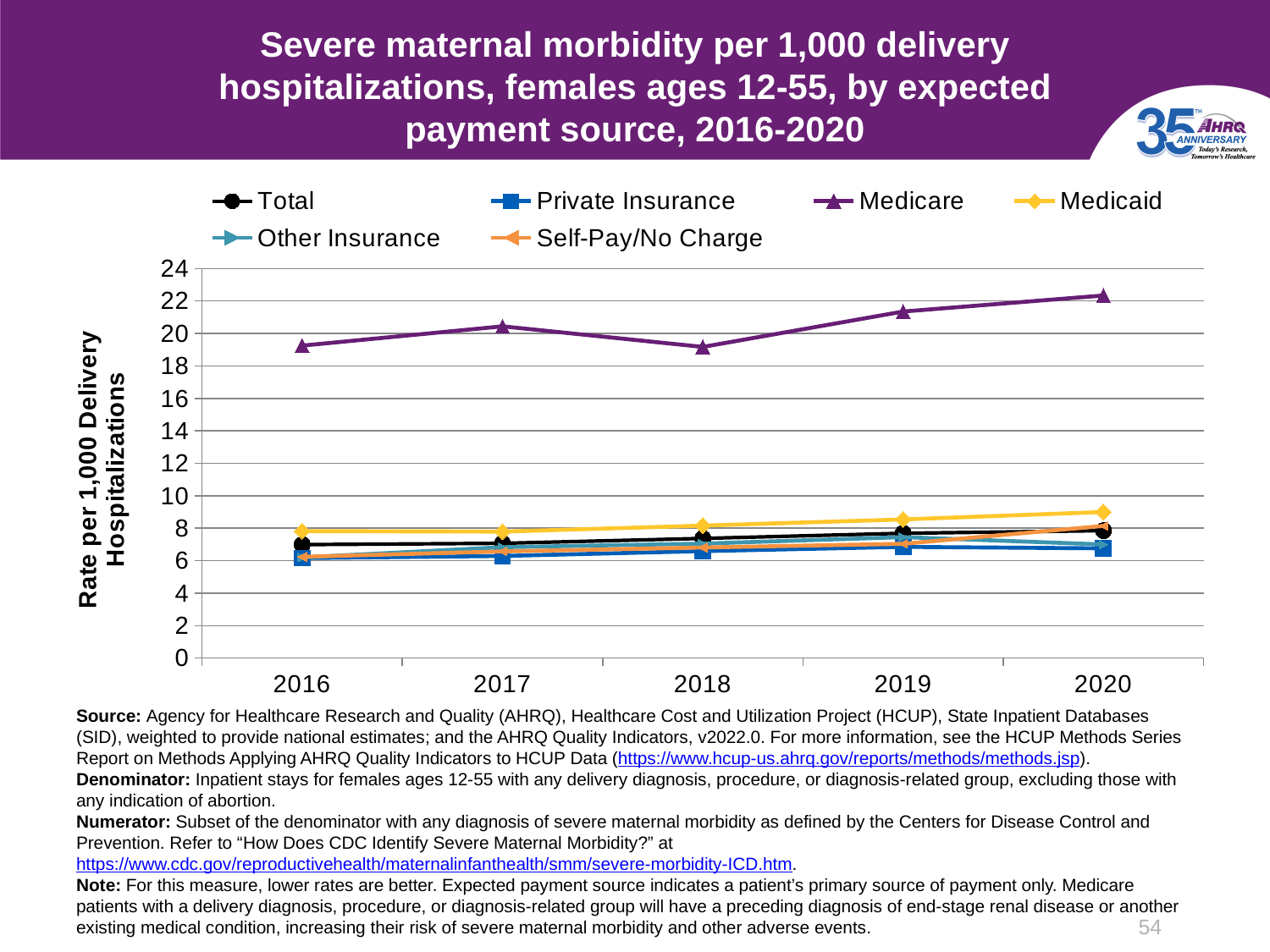
Does the Medicaid rate rise or fall from 2016 to 2020? rise Which payment source has the highest severe maternal morbidity rate in every year shown? Medicare What kind of chart is shown on the slide? line chart Is the value for Private Insurance in 2017 greater or less than 8? less Is the value for Medicare in 2019 greater or less than 20? greater Is the value for Total in 2016 greater or less than 8? less How many series does the legend list? 6 Which is larger in 2020, the value for Medicare or the value for Medicaid? Medicare How many years are plotted along the x axis? 5 What is the title of the y axis? Rate per 1,000 Delivery Hospitalizations